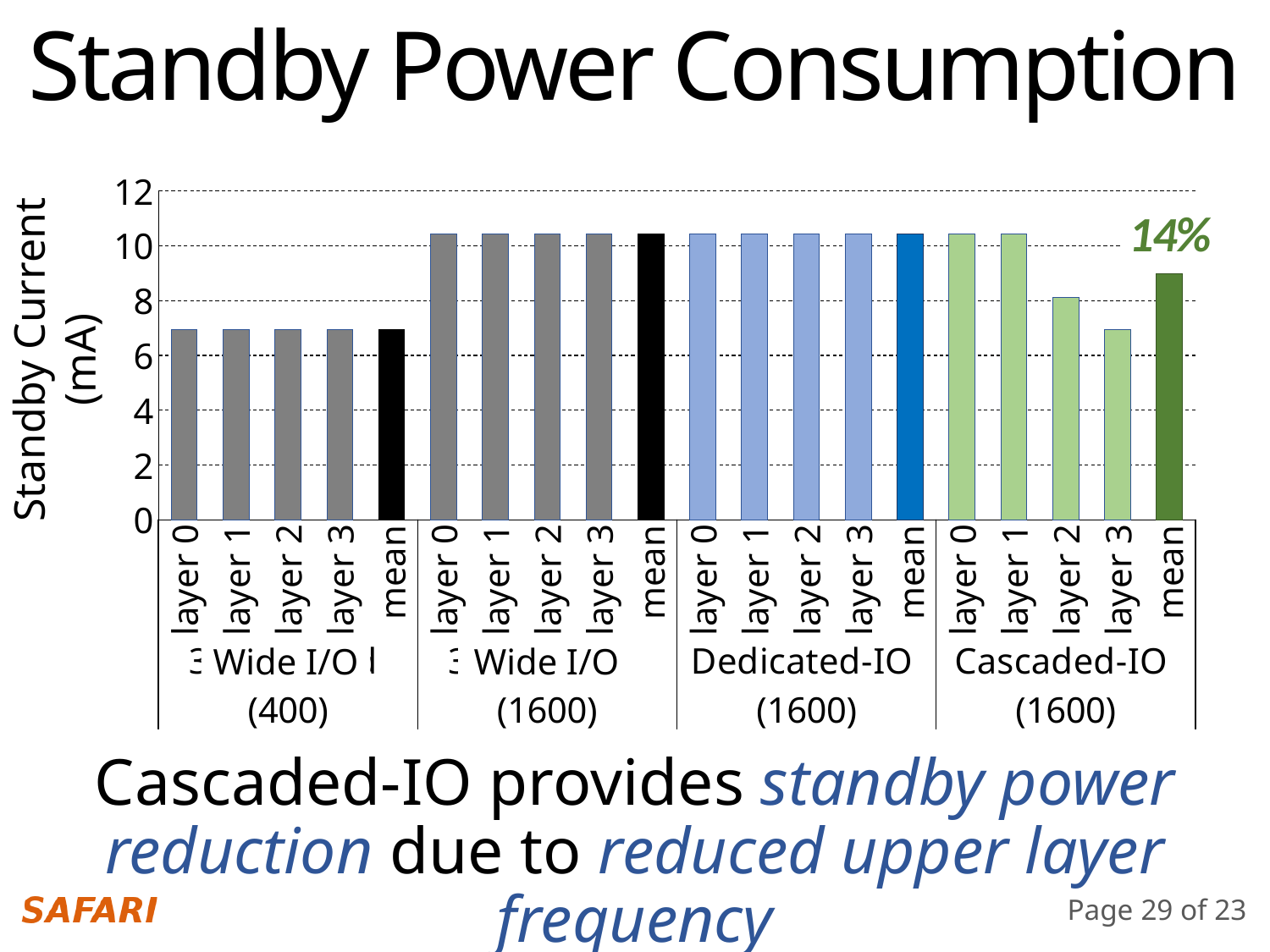
Which is larger, the mean standby current for Dedicated-IO (1600) or for Cascaded-IO (1600)? Dedicated-IO (1600) Is the mean standby current for Dedicated-IO (1600) greater or less than 10 mA? greater Is the mean standby current for Wide I/O (400) greater or less than 8 mA? less What percentage annotation is printed above the Cascaded-IO (1600) group? 14% Is the mean standby current for Cascaded-IO (1600) greater or less than 10 mA? less How many bars are plotted in the chart? 20 Which configuration group has the lowest mean standby current? Wide I/O (400) How many configuration groups are shown along the x axis? 4 Within the Cascaded-IO (1600) group, do the standby current values rise or fall from layer 0 to layer 3? fall What is the label of the y axis? Standby Current (mA) What kind of chart is shown on the slide? bar chart